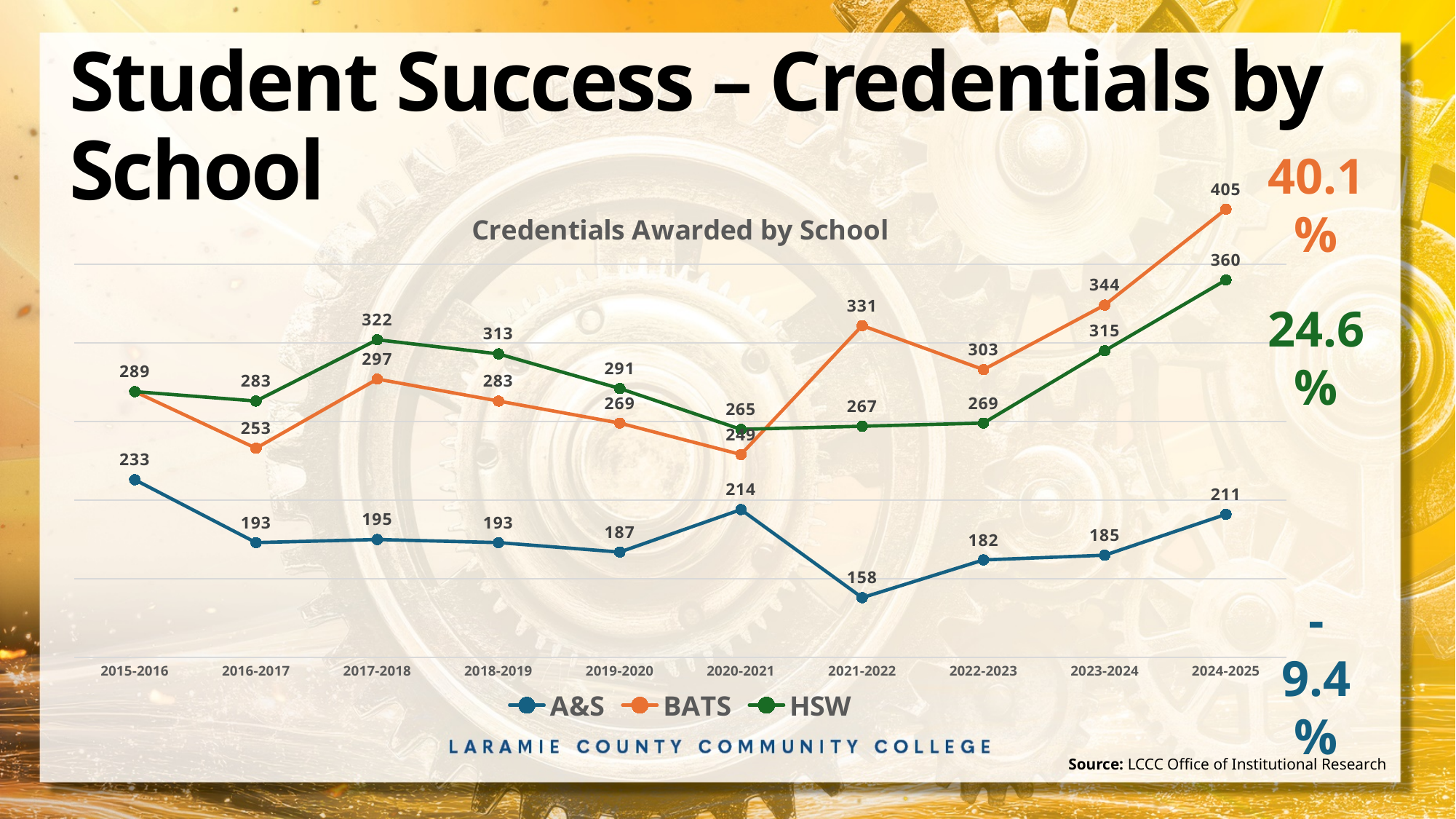
In which year does the HSW series reach its highest value? 2024-2025 What is the value for HSW in 2017-2018? 322 What type of chart is shown on the slide? line chart Which series has the larger value in 2020-2021, BATS or HSW? HSW What is the value for A&S in 2021-2022? 158 How many academic years are plotted along the x axis? 10 How many series does the legend list? 3 What is the title of the chart? Credentials Awarded by School Does the BATS series rise or fall from 2022-2023 to 2024-2025? rise What is the value for BATS in 2024-2025? 405 In which year does the A&S series reach its lowest value? 2021-2022 What is the difference between the BATS and HSW values in 2024-2025? 45